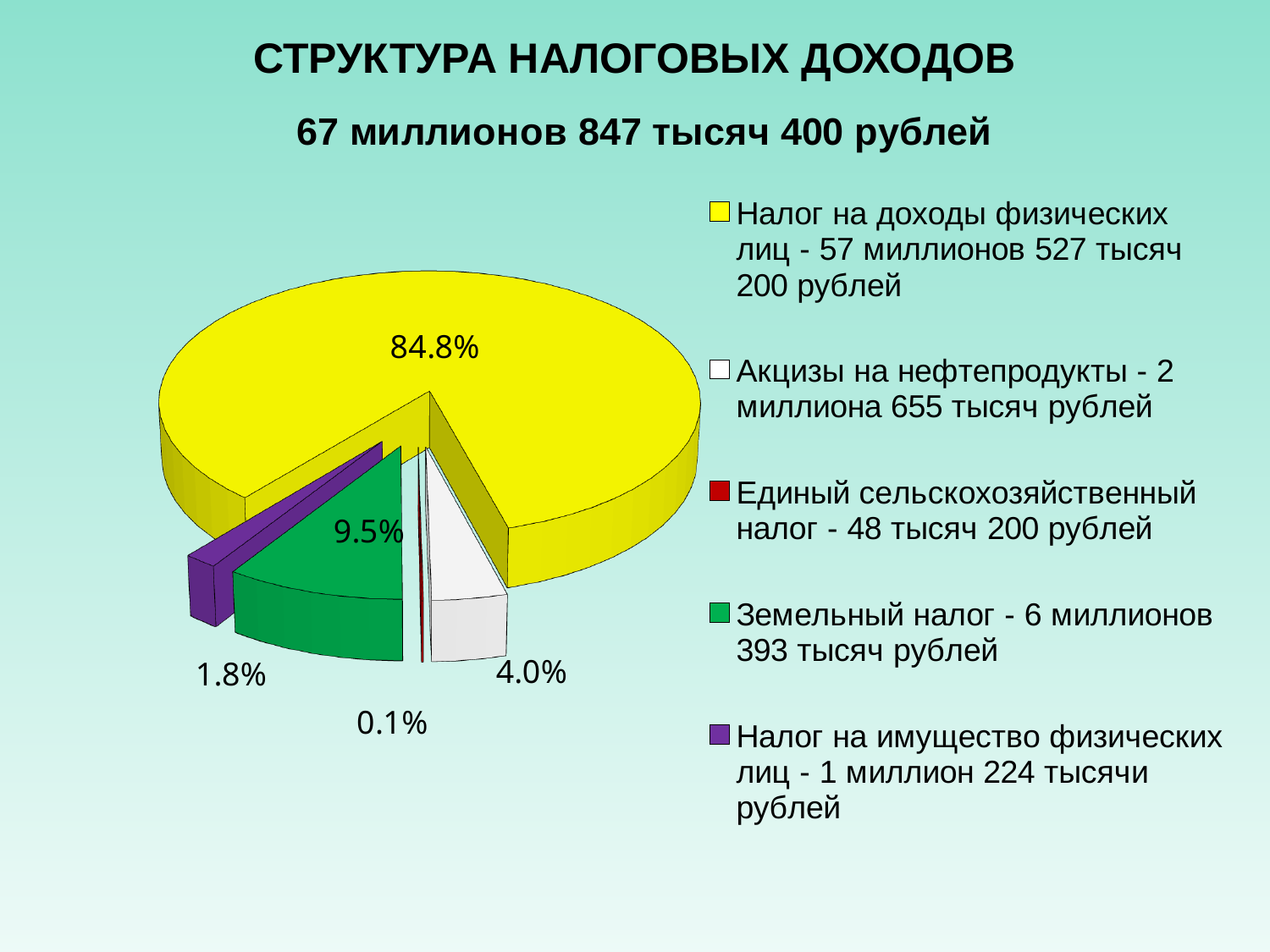
Which category has the largest slice of the pie? Налог на доходы физических лиц What share of the pie does "Налог на доходы физических лиц" take? 84.8% What share of the pie does "Налог на имущество физических лиц" take? 1.8% Which has the larger share: "Акцизы на нефтепродукты" or "Налог на имущество физических лиц"? Акцизы на нефтепродукты What colour is the slice for "Земельный налог"? green What kind of chart is shown on the slide? pie chart What share of the pie does "Акцизы на нефтепродукты" take? 4.0% How many slices does the pie chart have? 5 What is the difference in percentage points between the shares of "Земельный налог" and "Акцизы на нефтепродукты"? 5.5 Which category has the smallest slice of the pie? Единый сельскохозяйственный налог